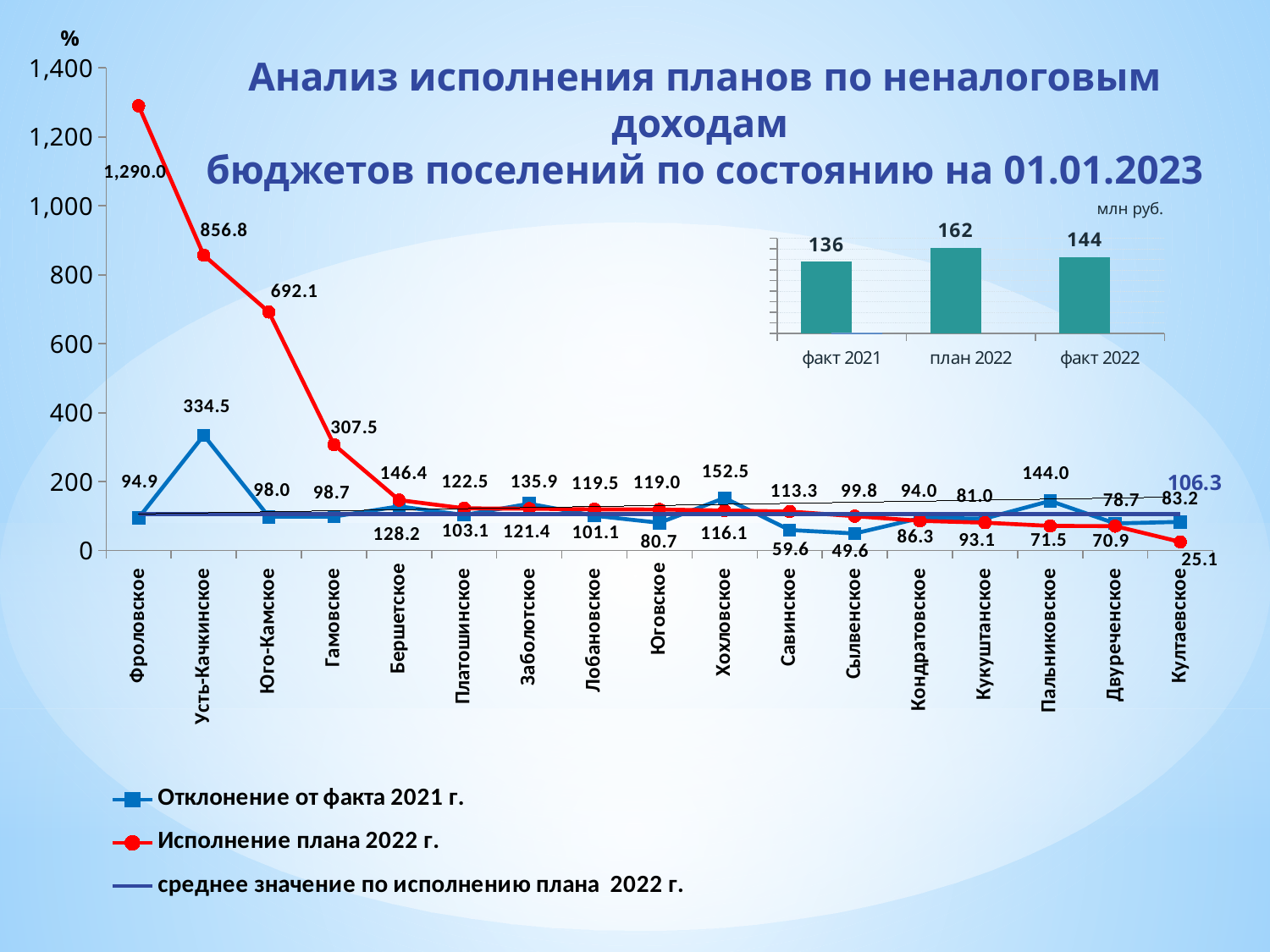
In the large line chart, how many settlements are shown on the x axis? 17 In the large line chart, how many series does the legend list? 3 In the large line chart, which settlement has the highest value for 'Исполнение плана 2022 г.'? Фроловское In the small bar chart (млн руб.), which category has the lowest value? факт 2021 In the large line chart, what is the value of 'Исполнение плана 2022 г.' for Усть-Качкинское? 856.8 In the large line chart, which settlement has the lowest value for 'Исполнение плана 2022 г.'? Култаевское In the large line chart, does the 'Исполнение плана 2022 г.' series generally rise or fall from left to right? fall In the large line chart, what is the value of 'Отклонение от факта 2021 г.' for Усть-Качкинское? 334.5 In the small bar chart (млн руб.), what is the difference between план 2022 and факт 2022? 18 In the small bar chart (млн руб.), what is the value for план 2022? 162 In the small bar chart (млн руб.), how many bars are there? 3 What kind of chart is the small chart in the upper right (млн руб.)? bar chart